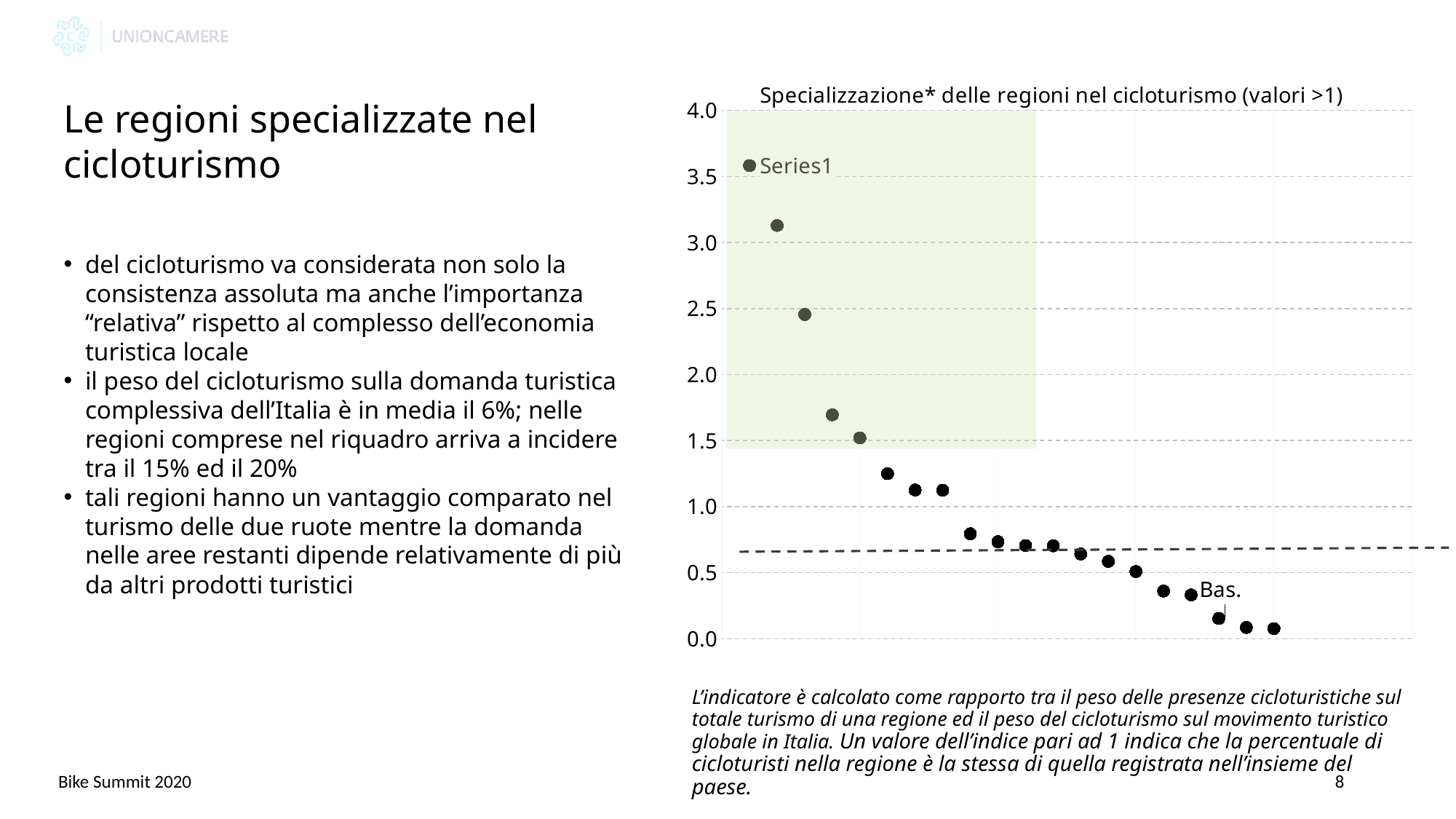
Do the plotted values rise or fall from left to right along the x axis? fall Is the lowest plotted value greater or less than 0.5? less How many plotted points have a value greater than 1.0? 8 What kind of chart is shown on the slide? scatter chart How many points are plotted in the chart? 20 What is the maximum value shown on the y axis? 4.0 What is the title of the chart? Specializzazione* delle regioni nel cicloturismo (valori >1) Is the highest plotted value greater or less than 3.5? greater Is the value of the point labelled "Bas." greater or less than 0.5? less